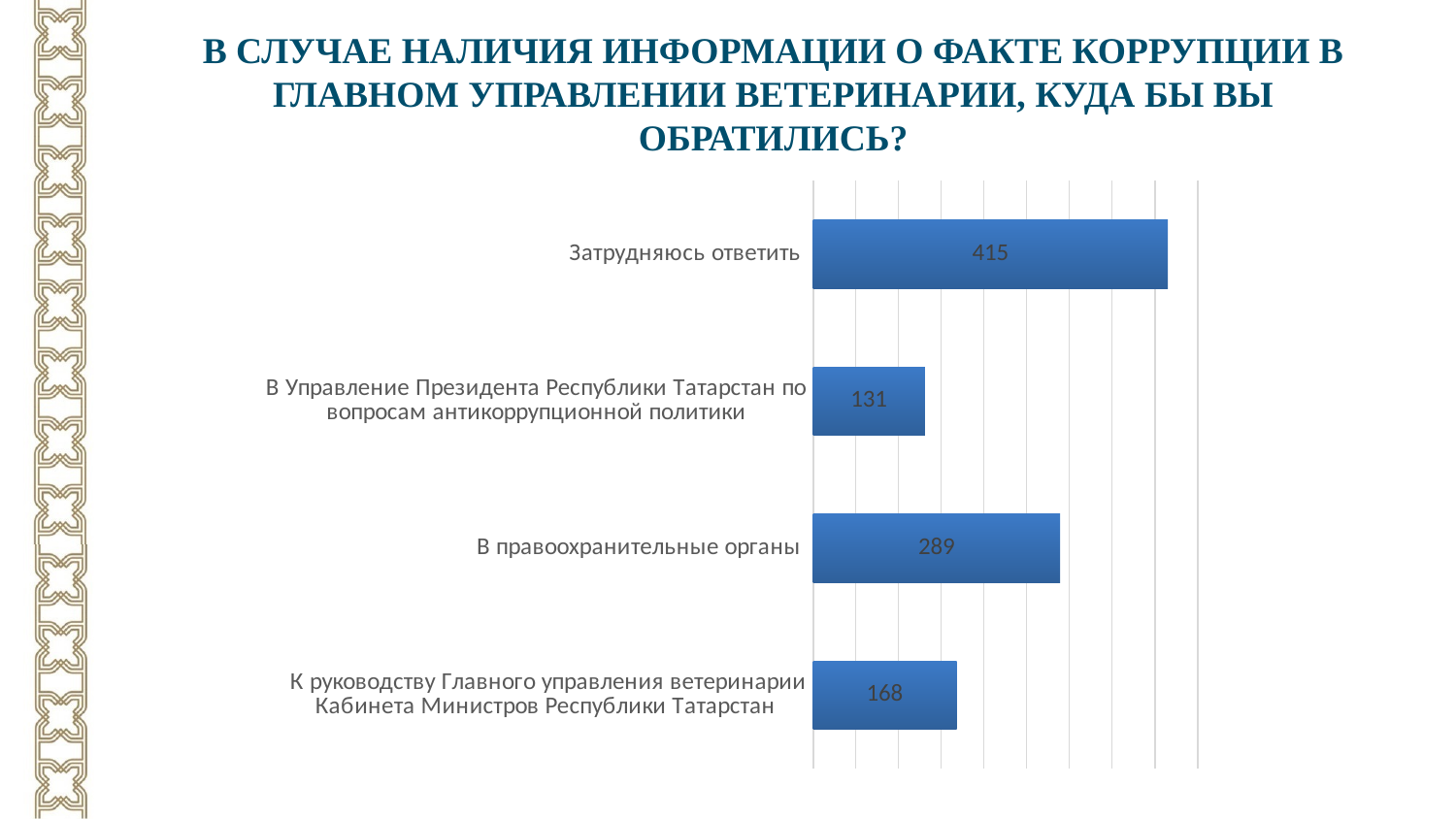
What is the difference between the values for "Затрудняюсь ответить" and "В правоохранительные органы"? 126 Which category has the highest value? Затрудняюсь ответить What is the value for "В правоохранительные органы"? 289 What is the value for "К руководству Главного управления ветеринарии Кабинета Министров Республики Татарстан"? 168 What is the difference between the values for "К руководству Главного управления ветеринарии Кабинета Министров Республики Татарстан" and "В Управление Президента Республики Татарстан по вопросам антикоррупционной политики"? 37 Which is larger: the value for "В правоохранительные органы" or the value for "К руководству Главного управления ветеринарии Кабинета Министров Республики Татарстан"? В правоохранительные органы What colour are the bars in the chart? Blue Which category has the lowest value? В Управление Президента Республики Татарстан по вопросам антикоррупционной политики What is the value for "Затрудняюсь ответить"? 415 What is the value for "В Управление Президента Республики Татарстан по вопросам антикоррупционной политики"? 131 How many categories are shown in the chart? 4 What kind of chart is shown on the slide? Bar chart